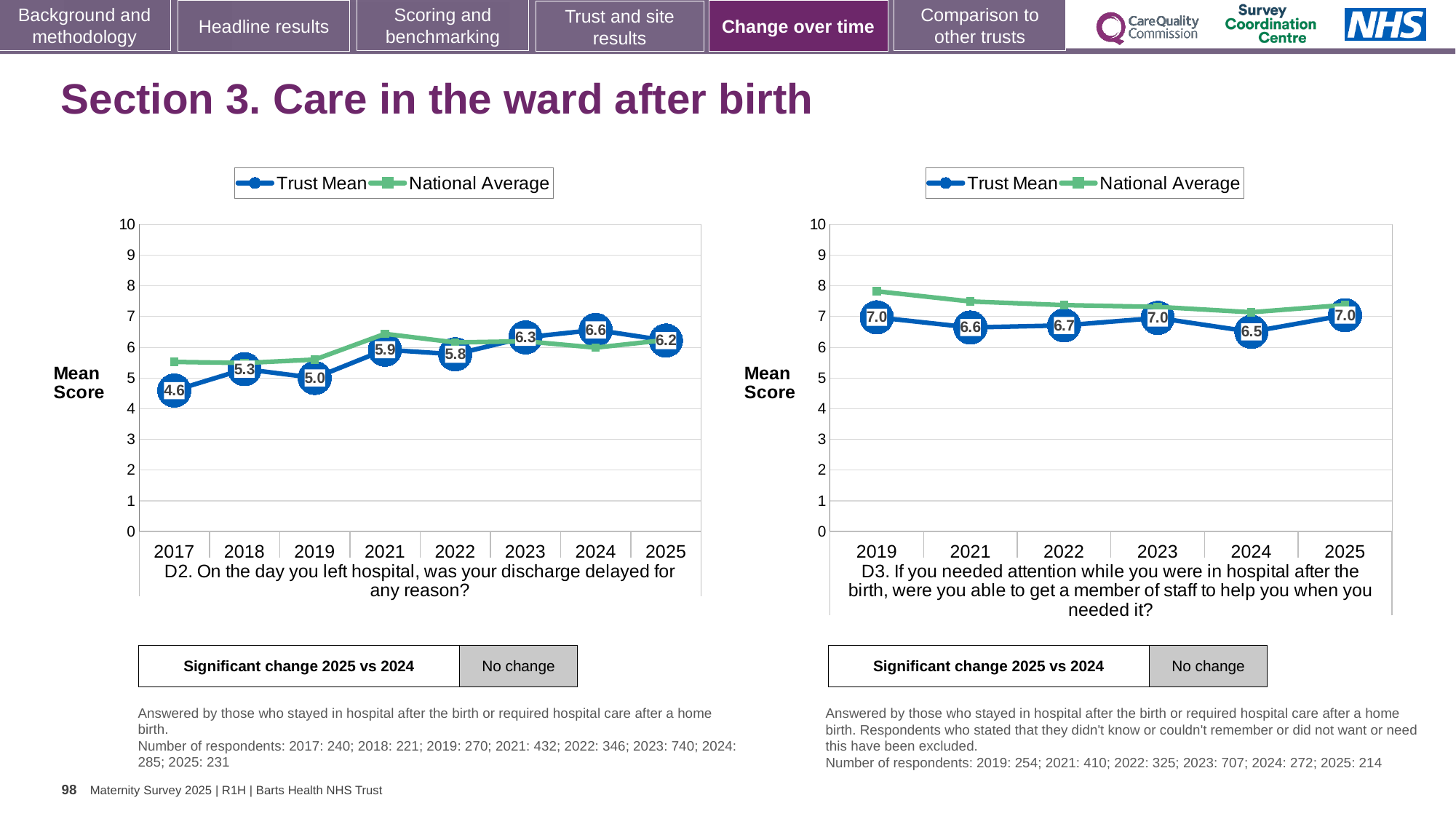
In the D2 chart (left), which year has the highest Trust Mean? 2024 In the D3 chart (right), is the Trust Mean for 2021 larger or smaller than the Trust Mean for 2022? smaller How many series does the legend of the D3 chart (right) list? 2 What kind of chart is the D2 chart (left)? Line chart In the D2 chart (left), what is the Trust Mean for 2017? 4.6 In the D2 chart (left), which year has the lowest Trust Mean? 2017 In the D2 chart (left), how many years are shown on the x axis? 8 In the D3 chart (right), what is the Trust Mean for 2024? 6.5 In the D2 chart (left), what is the Trust Mean for 2024? 6.6 In the D2 chart (left), what is the difference between the Trust Mean for 2024 and 2025? 0.4 In the D3 chart (right), which year has the lowest Trust Mean? 2024 In the D3 chart (right), is the National Average for 2019 greater or less than 7? greater